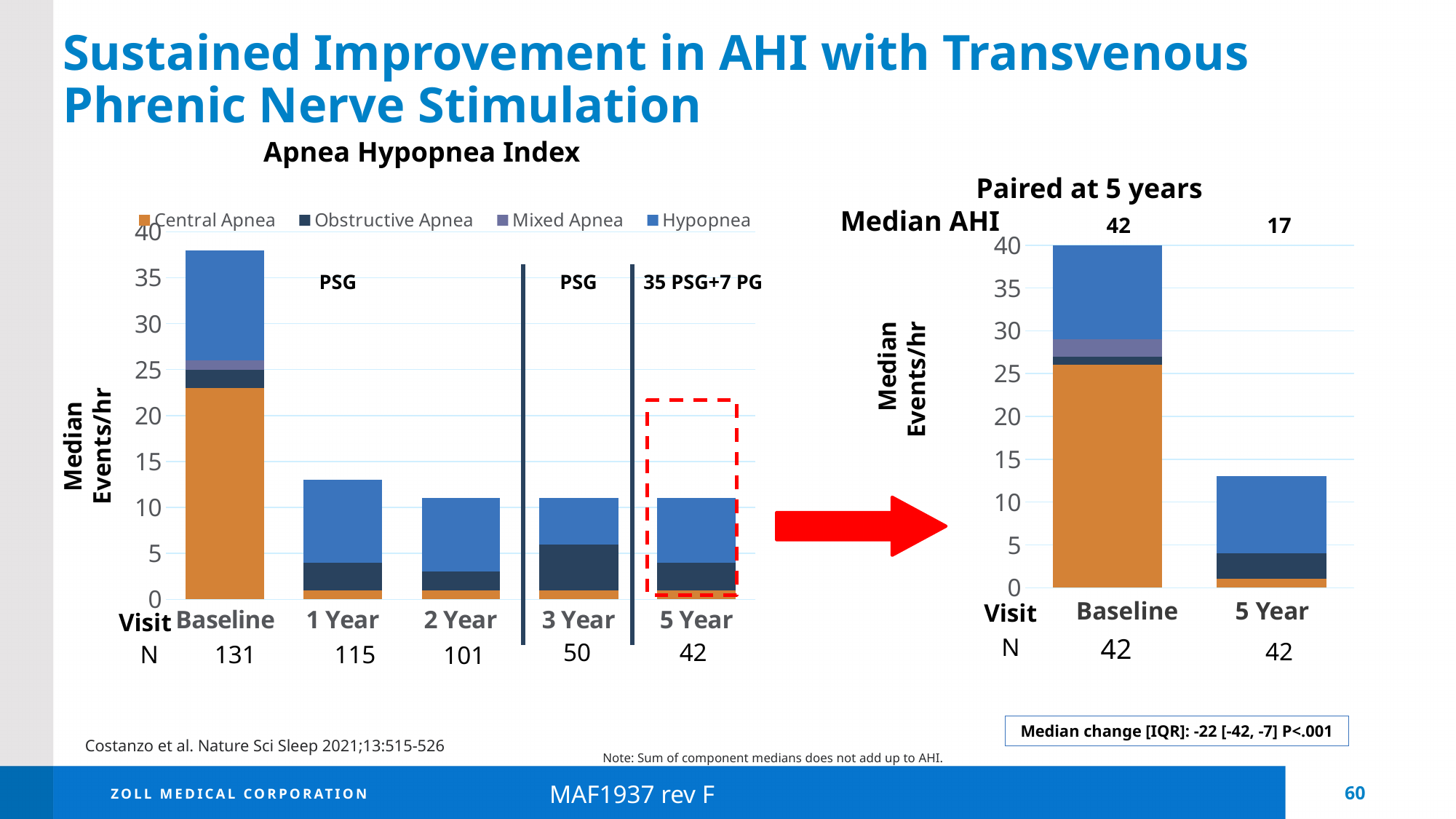
In the Paired at 5 years chart, what is the Median AHI shown for Baseline? 42 In the Paired at 5 years chart, what is the Median AHI shown for 5 Year? 17 In the Apnea Hypopnea Index chart, is the total value for Baseline greater or less than 35? greater In the Apnea Hypopnea Index chart, what is the N shown for the 3 Year visit? 50 In the Paired at 5 years chart, what is the difference between the Median AHI at Baseline and at 5 Year? 25 Which series in the Apnea Hypopnea Index chart legend is shown in orange? Central Apnea How many visit categories are shown on the x axis of the Apnea Hypopnea Index chart? 5 In the Apnea Hypopnea Index chart, is the total value for 1 Year greater or less than 15? less How many series does the legend of the Apnea Hypopnea Index chart list? 4 What kind of chart is the Apnea Hypopnea Index chart on the left? Stacked bar chart In the Apnea Hypopnea Index chart, which visit has the highest total median events/hr? Baseline In the Apnea Hypopnea Index chart, which is larger, the total for Baseline or the total for 5 Year? Baseline